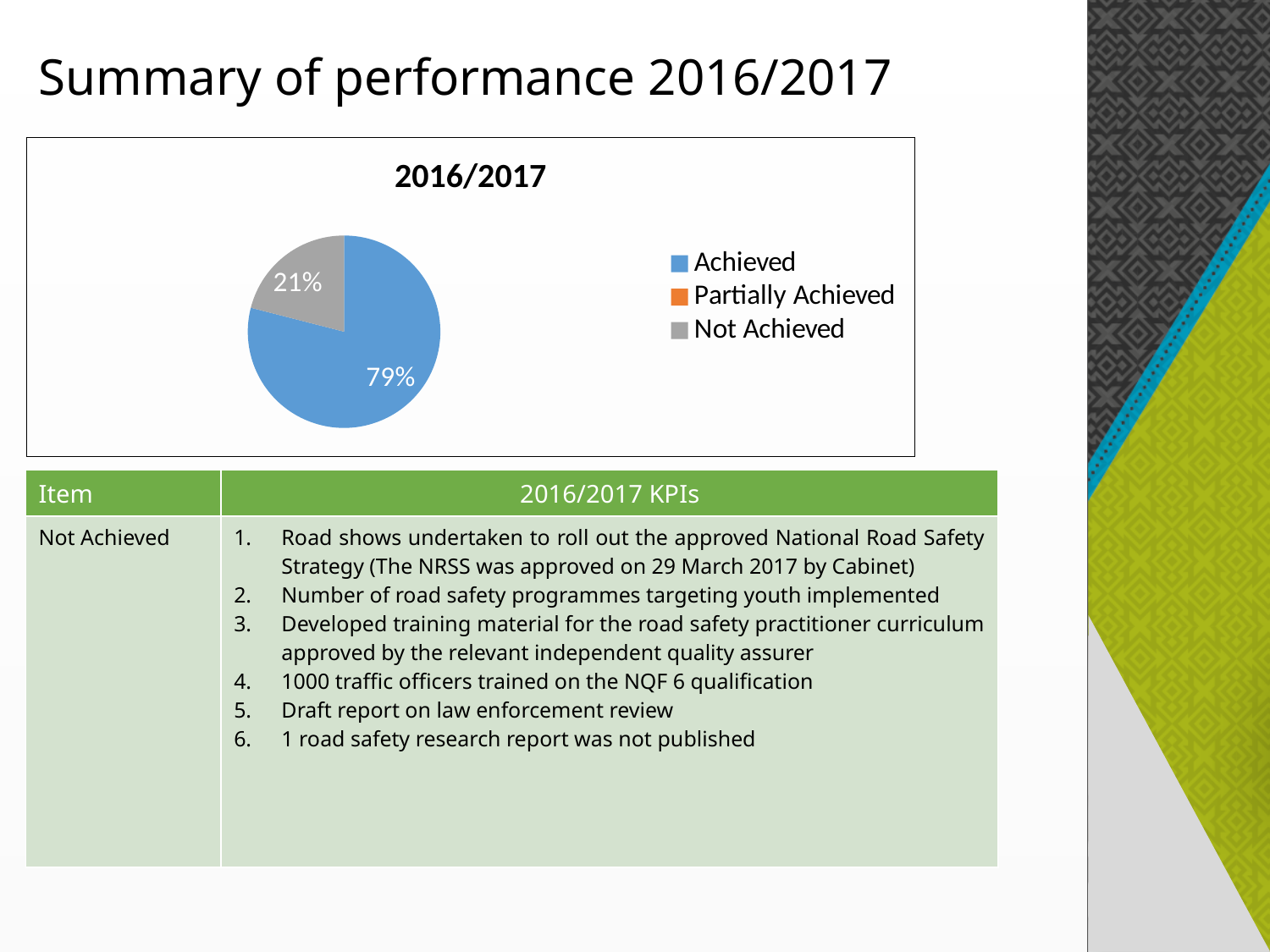
What is the title of the chart? 2016/2017 Is the Not Achieved share of the pie greater or less than 50%? less What type of chart is shown on the slide? pie chart How many entries does the chart legend list? 3 Which category has the largest slice of the pie? Achieved By how many percentage points does the Achieved slice exceed the Not Achieved slice? 58 What colour is the Achieved slice of the pie? blue What percentage of the pie is labelled Achieved? 79% Which is larger, the Achieved slice or the Not Achieved slice? Achieved What percentage of the pie is labelled Not Achieved? 21% Which of the two labelled slices is smaller, Achieved or Not Achieved? Not Achieved How many slices of the pie are labelled with a percentage? 2